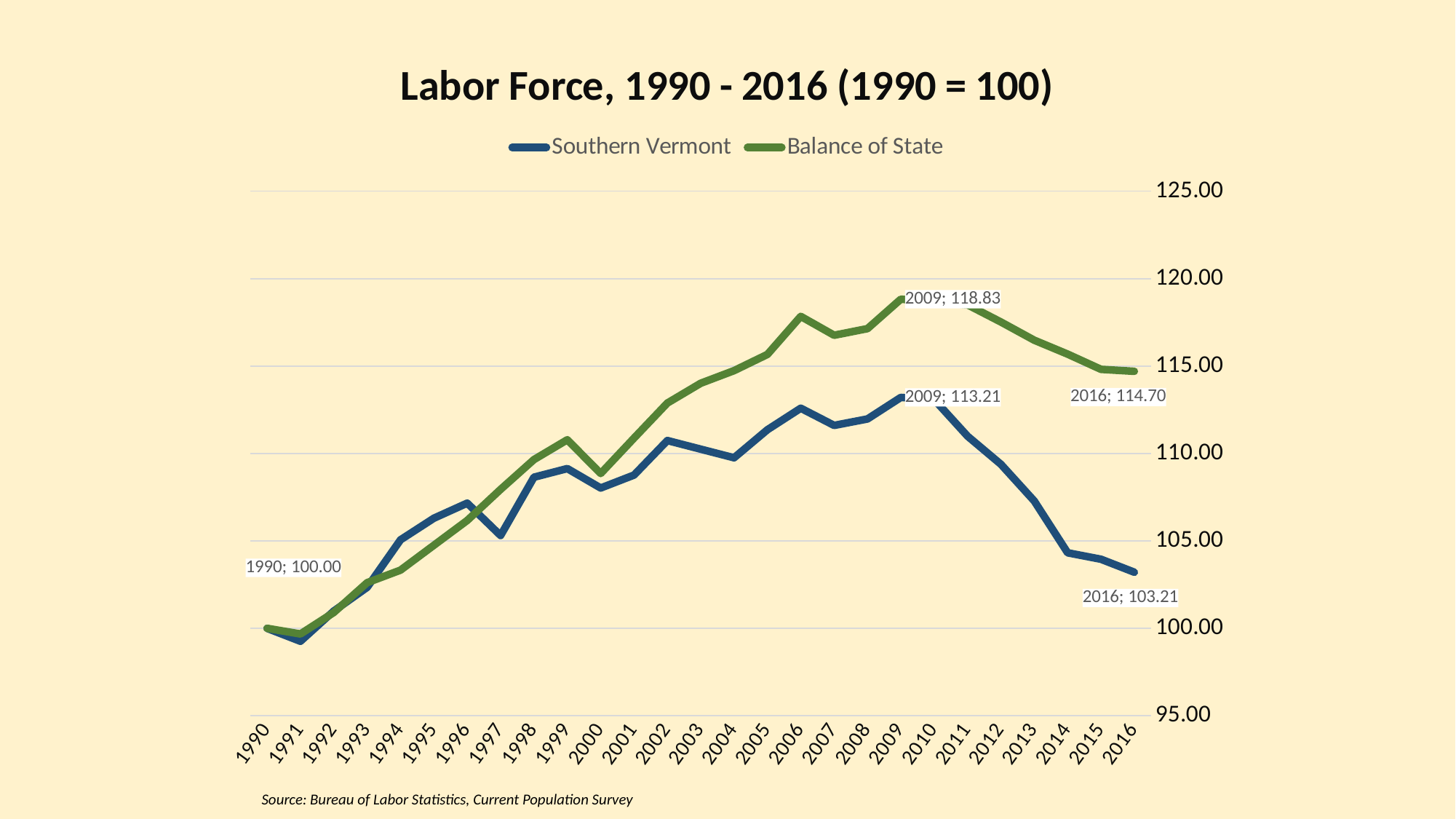
Which series has the higher value in 2016, Southern Vermont or Balance of State? Balance of State What is the value for Southern Vermont in 2016? 103.21 By how much did the Southern Vermont value fall from 2009 to 2016? 10.00 Is the value for Southern Vermont in 2014 greater or less than 105.00? less How many series does the legend list? 2 What is the value for Balance of State in 2009? 118.83 What is the value for Balance of State in 2016? 114.70 What is the value for Southern Vermont in 2009? 113.21 What is the difference between the Balance of State and Southern Vermont values in 2016? 11.49 What is the title of the chart? Labor Force, 1990 - 2016 (1990 = 100) How many years are shown on the x axis? 27 What type of chart is shown on the slide? Line chart